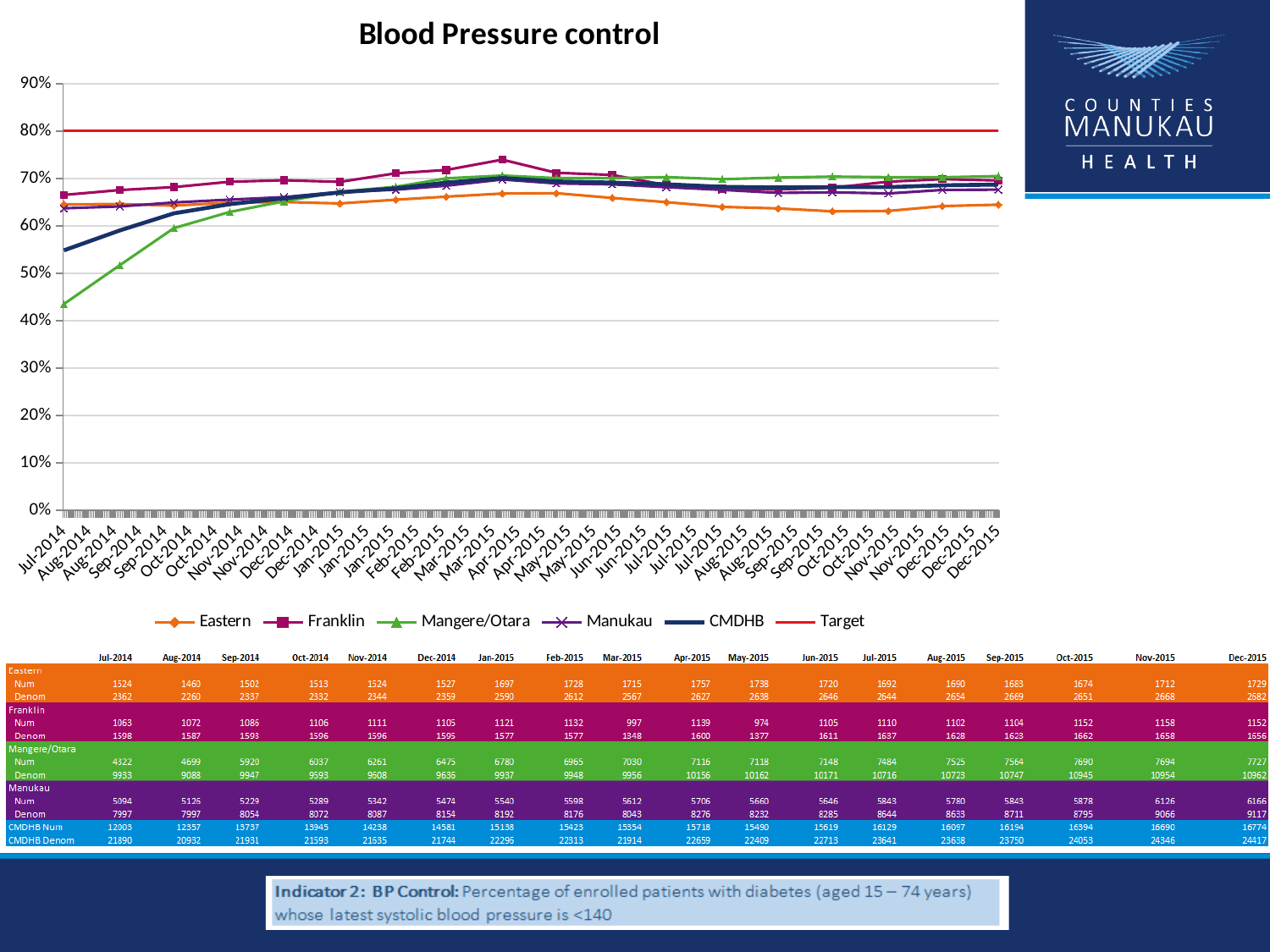
What kind of chart is shown on the slide? line chart Is the value for Mangere/Otara in Jul-2014 greater or less than 50%? less Does the Mangere/Otara series rise or fall between Jul-2014 and Dec-2014? rise Is the value for Eastern in Dec-2015 greater or less than 70%? less How many series does the chart legend list? 6 Which series is drawn as a flat horizontal line across the chart? Target Which series has the lowest value in Jul-2014? Mangere/Otara Is the value for CMDHB in Jul-2014 greater or less than 60%? less In Apr-2015, which is higher: the Target line or the Franklin series? Target What is the title of the chart? Blood Pressure control